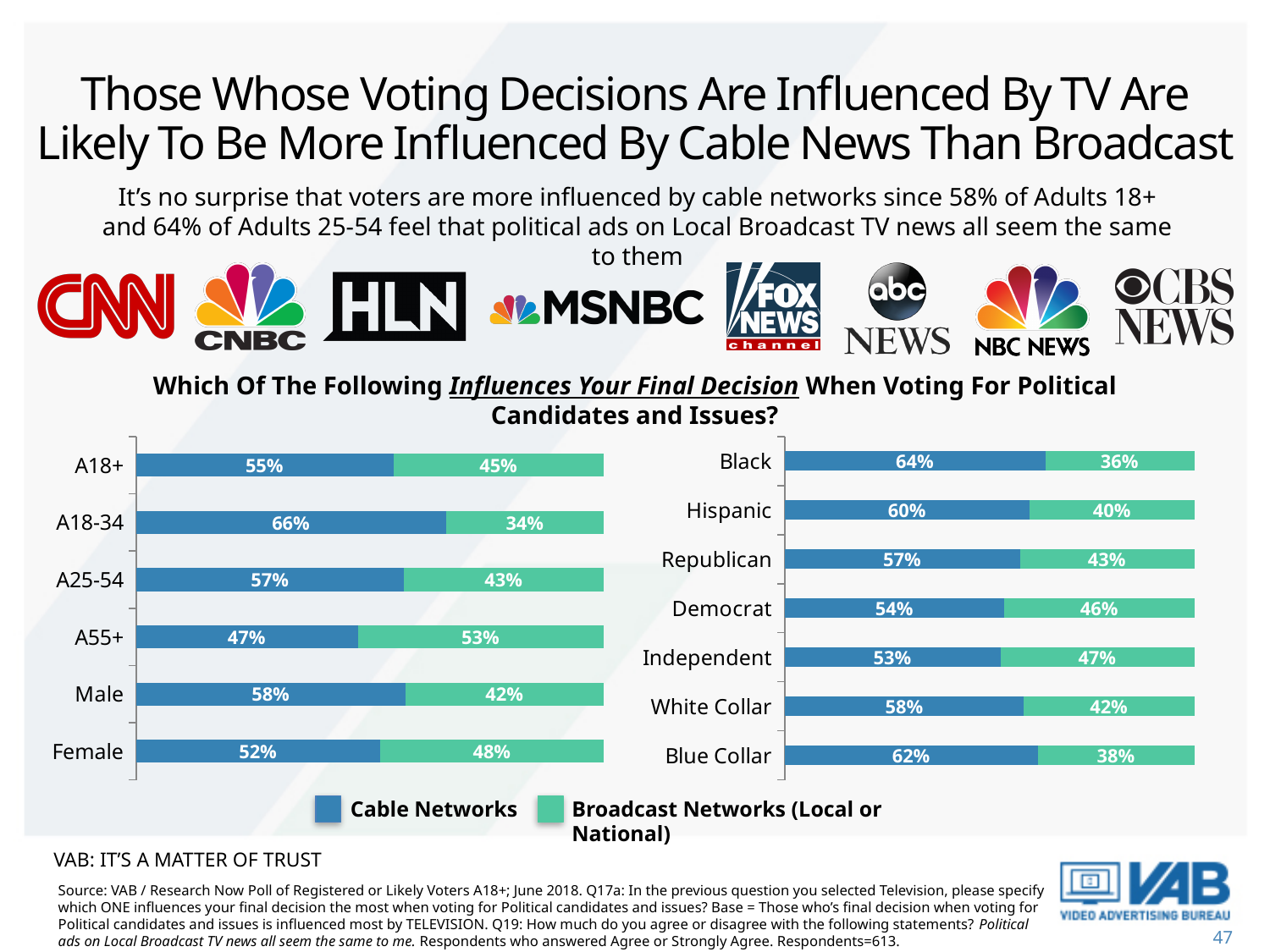
What type of chart is used on this slide? Stacked bar chart How many categories are shown in the right chart? 7 In the left chart, what is the difference between the Cable Networks values for Male and Female? 6% In the left chart, which category has the highest Cable Networks value? A18-34 In the right chart, which is larger: the Cable Networks value for Black or for Hispanic? Black In the left chart, what percentage of A18-34 say Cable Networks influence their final decision? 66% In the right chart, which category has the lowest Cable Networks value? Independent How many series does the legend list? 2 In the left chart, what is the total of the A55+ bar? 100% In the right chart, what is the Broadcast Networks value for Blue Collar? 38% How many categories are shown in the left chart? 6 Which series is shown in green in the legend? Broadcast Networks (Local or National)